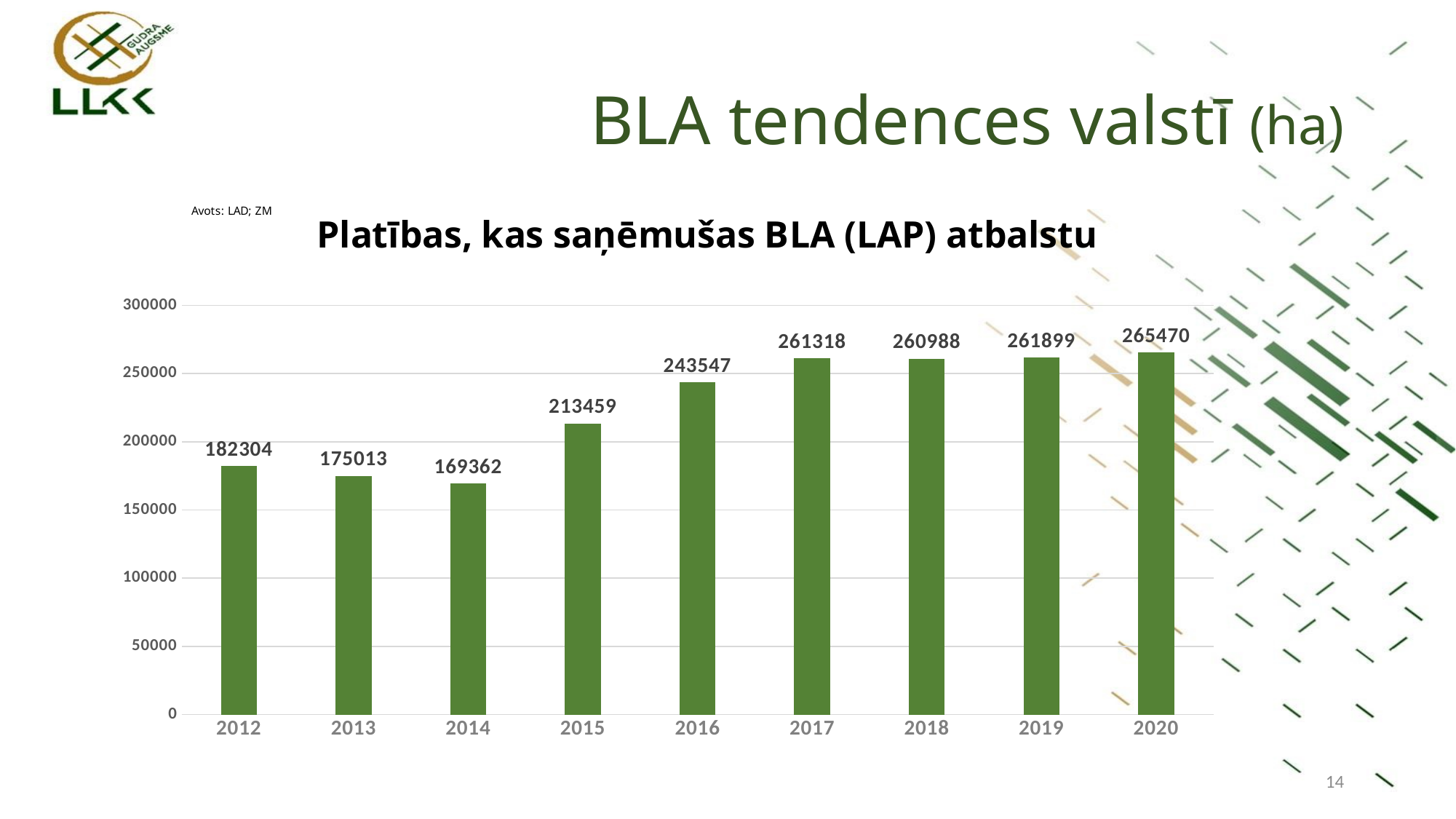
What is the difference between the values for 2020 and 2012? 83166 Which is larger, the value for 2017 or the value for 2018? 2017 What is the difference between the values for 2015 and 2014? 44097 What is the value for 2019? 261899 How many years are shown on the x axis? 9 Which year has the lowest value? 2014 What kind of chart is shown on the slide? bar chart Is the value for 2013 greater or less than 200000? less What is the value for 2012? 182304 What is the value for 2016? 243547 Which year has the highest value? 2020 What is the title of the chart? Platības, kas saņēmušas BLA (LAP) atbalstu